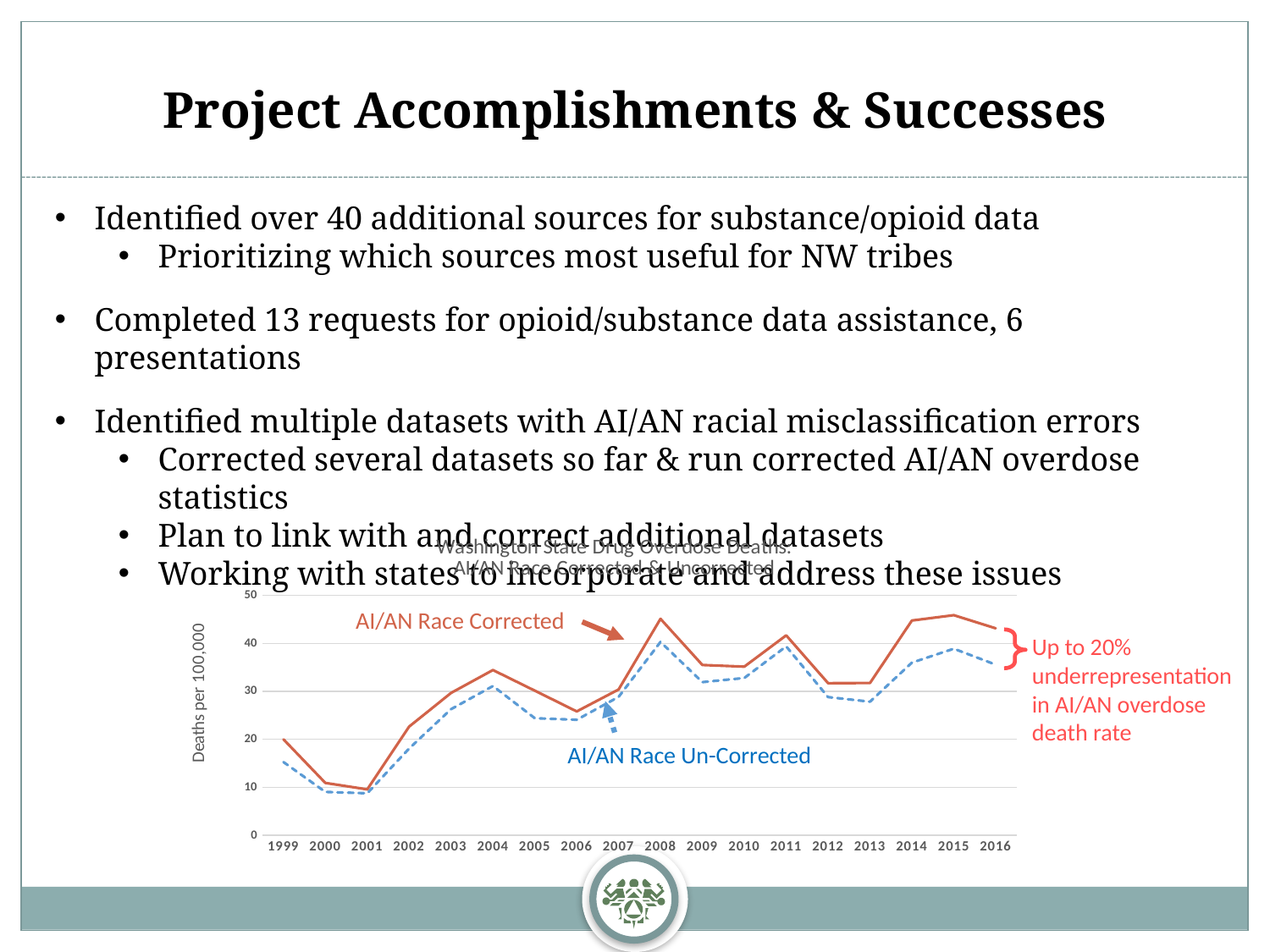
How many data series are plotted in the chart? 2 Is the AI/AN Race Un-Corrected value for 2006 greater or less than 30? less What is the label on the y axis of the chart? Deaths per 100,000 Is the AI/AN Race Corrected value for 2008 greater or less than 40? greater Is the AI/AN Race Corrected value for 2015 greater or less than 40? greater In which year does the AI/AN Race Corrected line reach its highest value? 2015 In 2008, which series has the larger value, AI/AN Race Corrected or AI/AN Race Un-Corrected? AI/AN Race Corrected In which year does the AI/AN Race Corrected line reach its lowest value? 2001 What kind of chart is shown on the slide? Line chart How many years are plotted along the x axis of the chart? 18